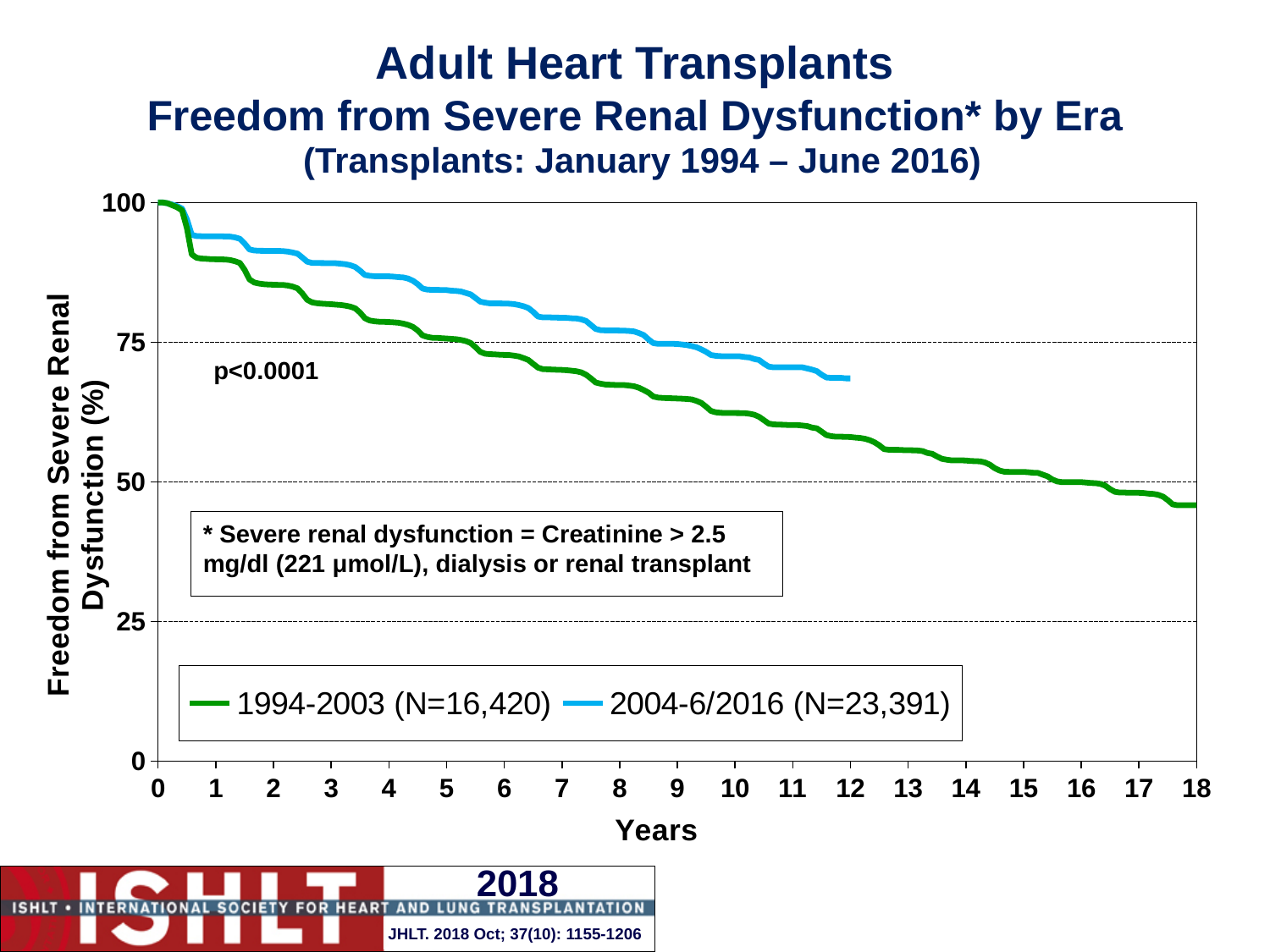
What are the two series named in the legend? 1994-2003 (N=16,420) and 2004-6/2016 (N=23,391) How many series does the legend list? 2 What kind of chart is shown on the slide? line chart What is the highest value shown on the x axis (Years)? 18 Which series has the higher freedom from severe renal dysfunction at 8 years, 1994-2003 or 2004-6/2016? 2004-6/2016 Is the value for the 1994-2003 series at 18 years greater or less than 50? less Do the values for the 1994-2003 series rise or fall as years increase? fall Is the value for the 1994-2003 series at 10 years greater or less than 50? greater Is the value for the 2004-6/2016 series at 6 years greater or less than 75? greater What is the p-value printed on the chart? p<0.0001